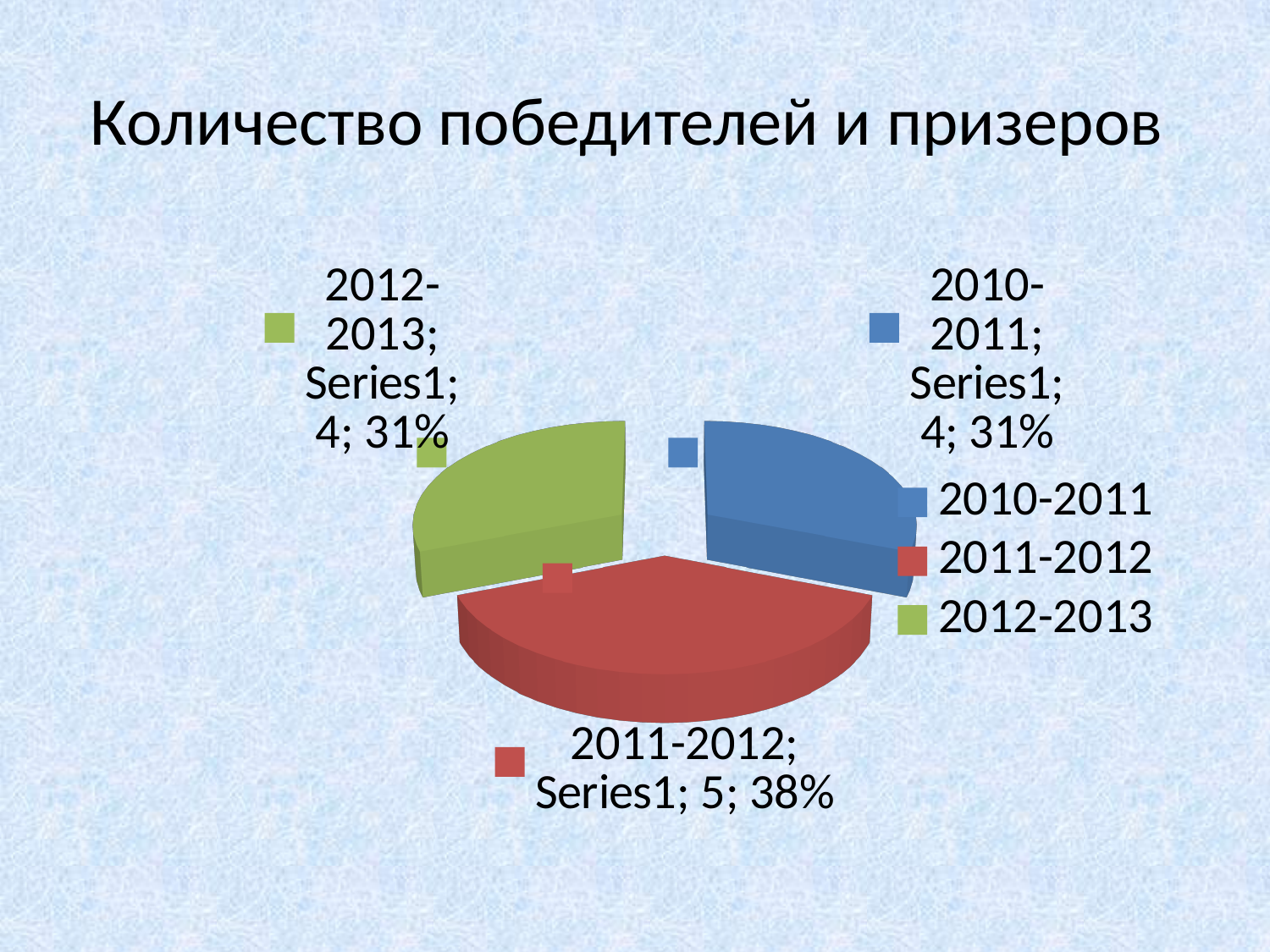
What share of the pie does 2010-2011 take? 31% What is the value for 2010-2011? 4 What colour is the slice for 2012-2013? green What share of the pie does 2011-2012 take? 38% How many slices does the pie chart have? 3 What is the title of the chart? Количество победителей и призеров What is the value for 2011-2012? 5 What kind of chart is shown on the slide? pie chart What is the difference between the values for 2011-2012 and 2012-2013? 1 Which category has the largest slice? 2011-2012 What is the value for 2012-2013? 4 Which is larger, the value for 2011-2012 or the value for 2010-2011? 2011-2012